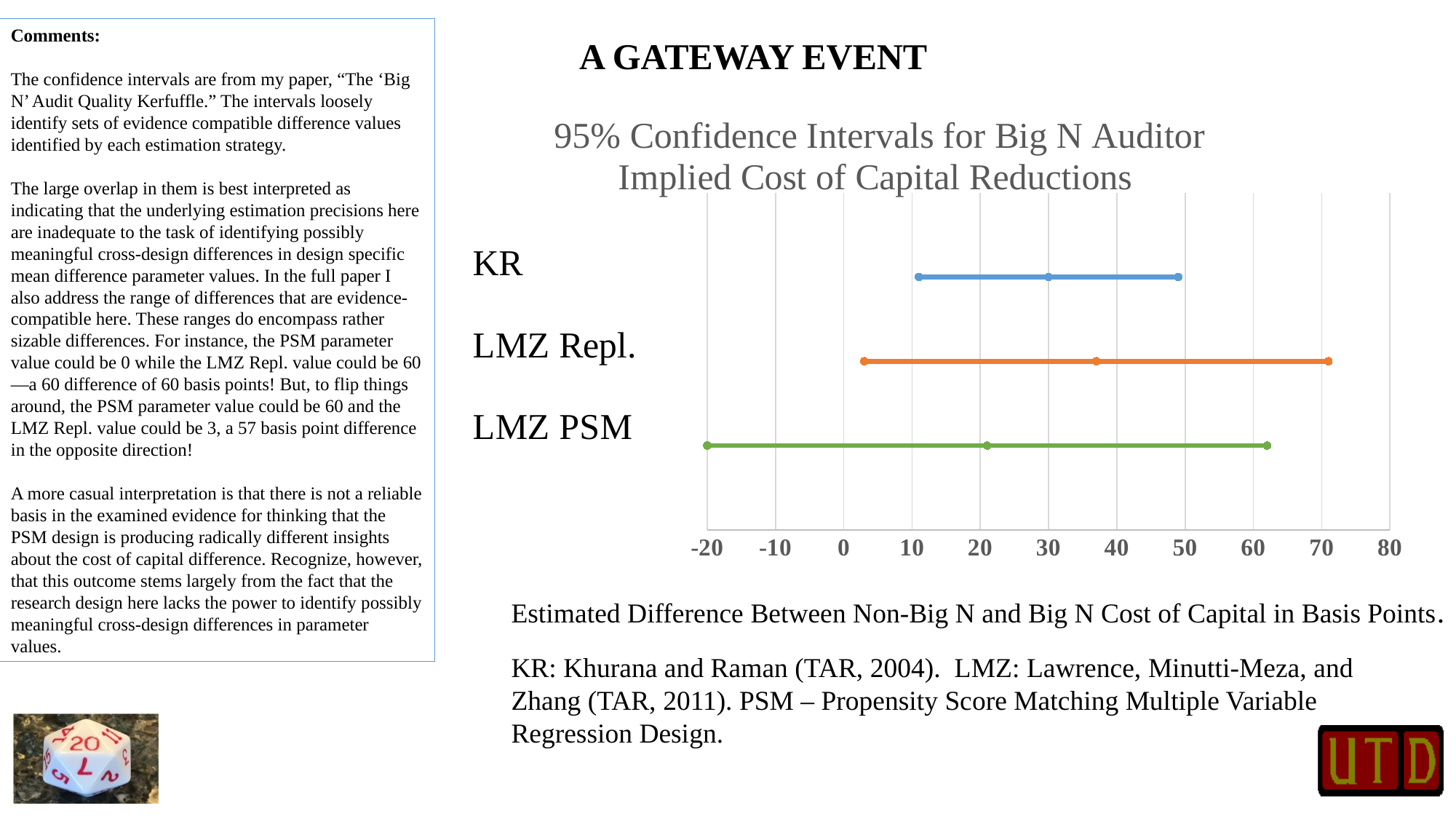
Which category has the narrowest confidence interval? KR Is the lower bound of the LMZ PSM interval greater or less than -10? less Which category has the lowest lower bound of its confidence interval? LMZ PSM How many confidence intervals (categories) are plotted on the chart? 3 What is the title of the chart? 95% Confidence Intervals for Big N Auditor Implied Cost of Capital Reductions What colour is the line for LMZ Repl.? Orange Which category has the highest upper bound of its confidence interval? LMZ Repl. Which category has the widest confidence interval? LMZ PSM Which is larger, the midpoint of the LMZ Repl. interval or the midpoint of the LMZ PSM interval? LMZ Repl.